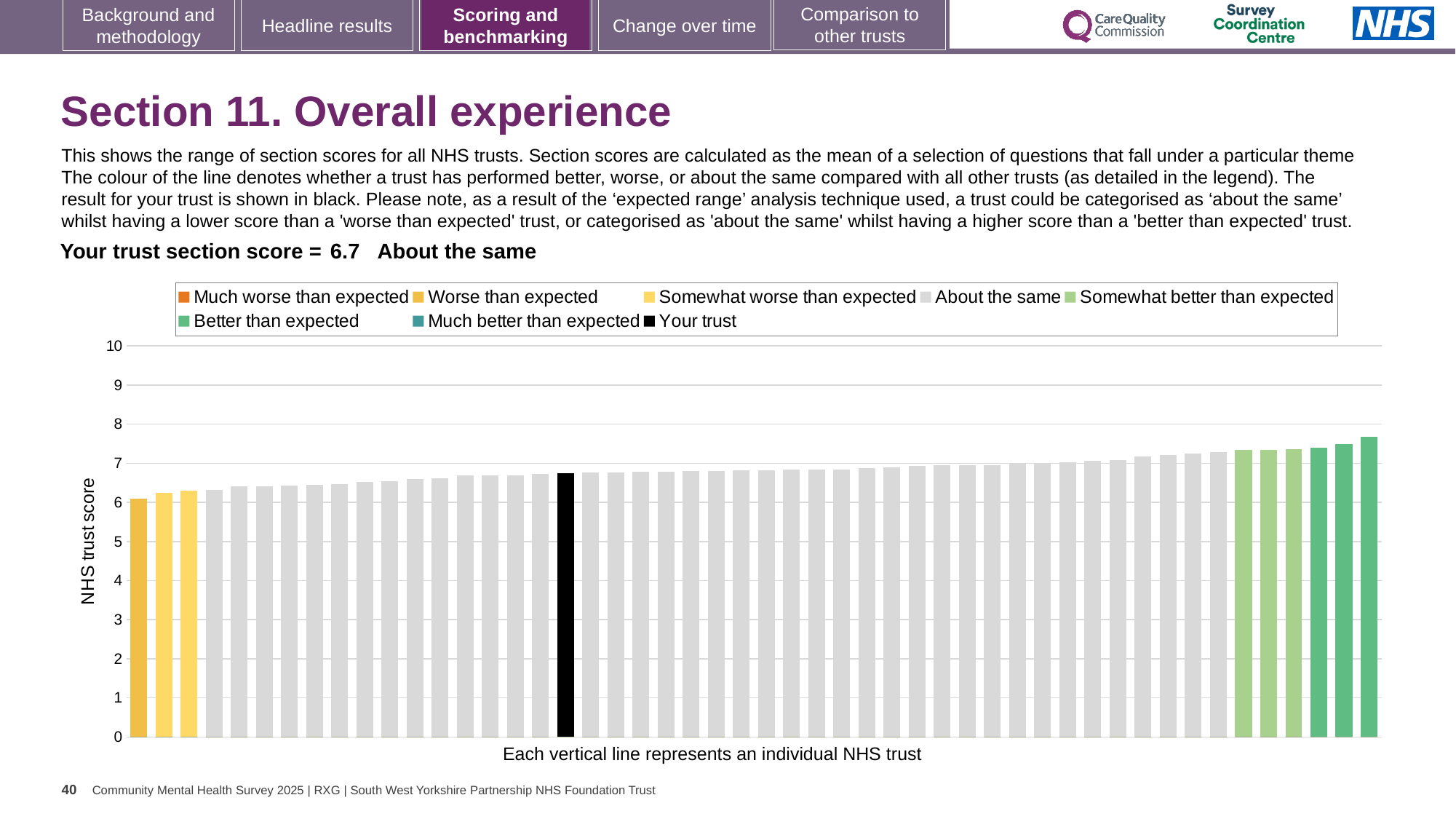
Is the tallest bar in the chart greater or less than 7? greater What kind of chart is shown on the slide? Bar chart What is the label on the vertical axis of the chart? NHS trust score Is the value for your trust (the black bar) greater or less than 7? less Do the bar values rise or fall from left to right along the x axis? Rise Is the value for your trust (the black bar) greater or less than 6? greater Which category is your trust placed in for this section? About the same What is the section score for your trust shown on the slide? 6.7 What colour is the bar representing your trust? Black What is the highest value shown on the vertical axis? 10 How many entries does the chart legend list? 8